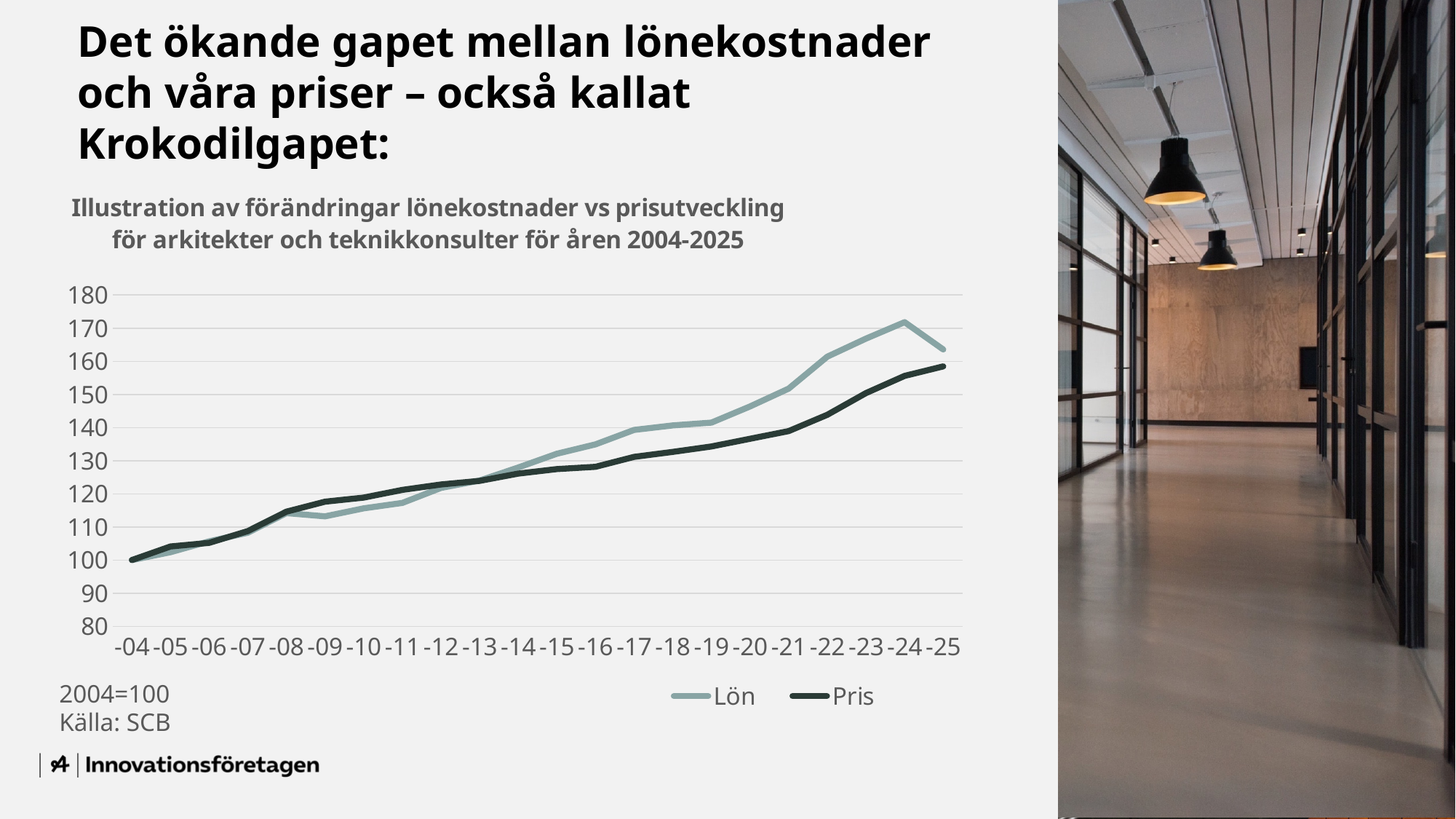
How many series does the legend list? 2 Which series has the higher value in -25, Lön or Pris? Lön Is the value for Lön in -20 greater or less than 140? greater How many years are plotted along the x axis? 22 In which year is the Pris series at its lowest value? -04 What kind of chart is shown on the slide? line chart What is the value of both series in -04? 100 What are the two series named in the legend? Lön and Pris Which series has the higher value in -09, Lön or Pris? Pris Is the value for Lön in -25 greater or less than 160? greater Is the value for Pris in -13 greater or less than 120? greater In which year does the Lön series reach its highest value? -24